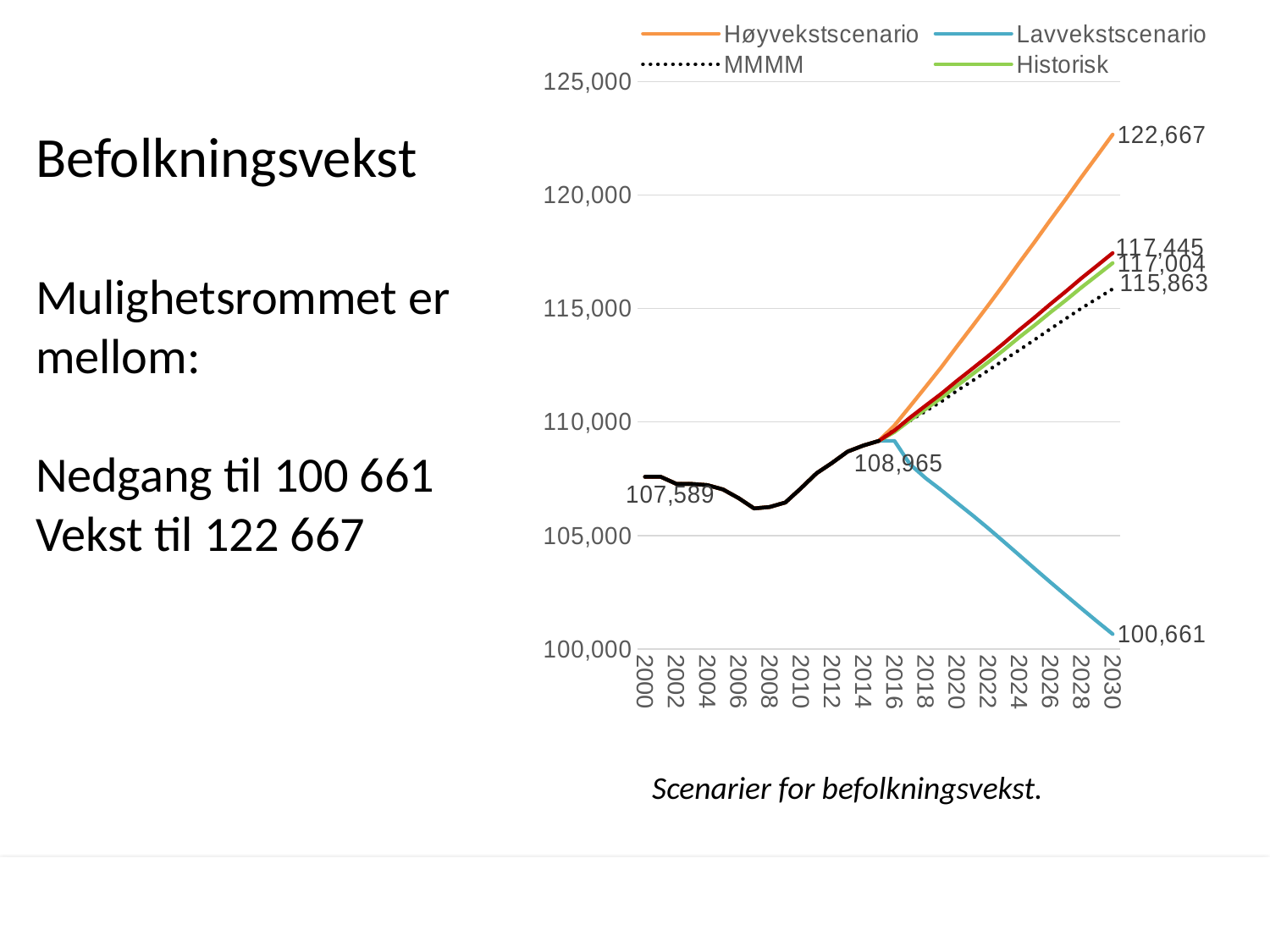
What is the value labelled in 2016 where the scenarios branch off? 108,965 What is the value labelled at the start of the series in 2000? 107,589 What is the value of Høyvekstscenario in 2030? 122,667 Which scenario has the highest value in 2030? Høyvekstscenario What is the value of Lavvekstscenario in 2030? 100,661 What is the difference between the Høyvekstscenario and Lavvekstscenario values in 2030? 22,006 What is the value of MMMM in 2030? 115,863 What is the caption printed below the chart? Scenarier for befolkningsvekst. Does the Lavvekstscenario line rise or fall from 2016 to 2030? fall How many series does the chart legend list? 4 What kind of chart is shown on the slide? line chart Which scenario has the lowest value in 2030? Lavvekstscenario